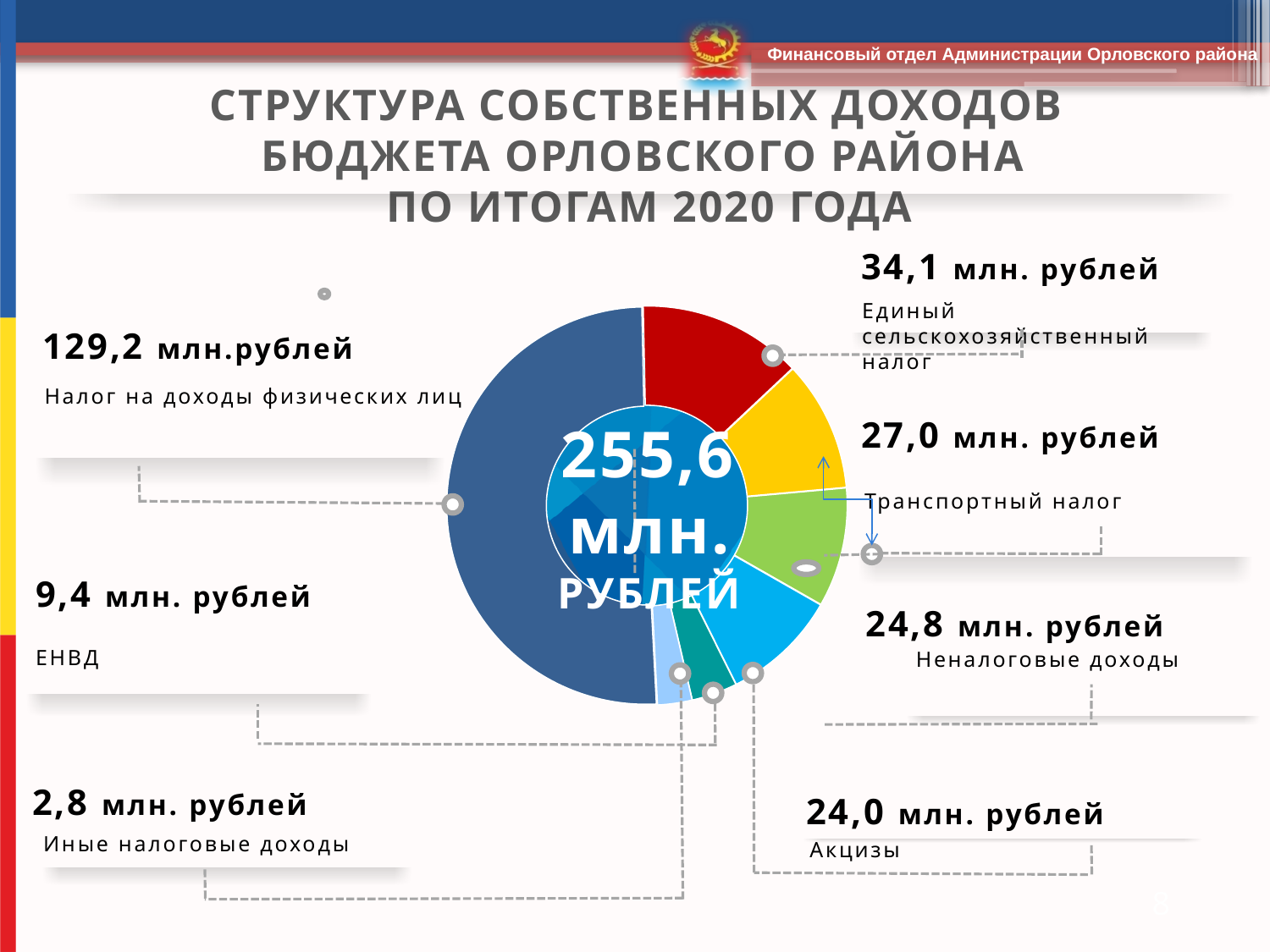
What value is shown for Транспортный налог? 27,0 млн. рублей Which category has the smallest value? Иные налоговые доходы What value is shown for Налог на доходы физических лиц? 129,2 млн.рублей How many categories are shown in the chart? 7 What value is shown for Акцизы? 24,0 млн. рублей What total value is printed in the centre of the chart? 255,6 млн. рублей What value is shown for ЕНВД? 9,4 млн. рублей What value is shown for Единый сельскохозяйственный налог? 34,1 млн. рублей What kind of chart is shown on the slide? Doughnut (pie) chart Which category has the largest value? Налог на доходы физических лиц What is the difference between Налог на доходы физических лиц and Единый сельскохозяйственный налог? 95,1 млн. рублей Which is larger: Единый сельскохозяйственный налог or Транспортный налог? Единый сельскохозяйственный налог